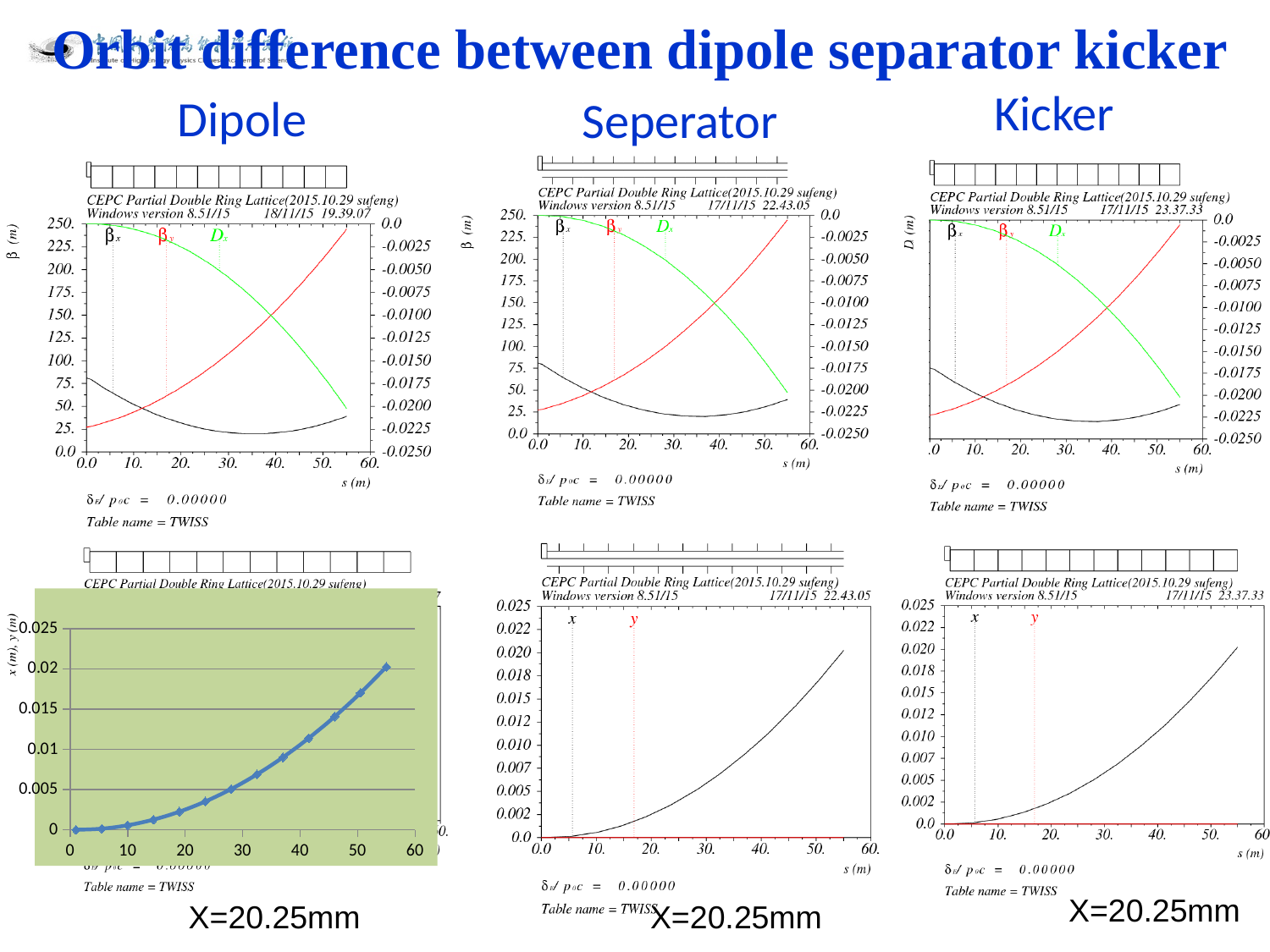
What X value is printed beneath each of the three bottom orbit charts? X=20.25mm In the bottom-left chart under the Dipole column, is the value at the last point (around s=55) greater or less than 0.015? greater In the bottom-middle orbit chart under the Seperator column, is the x value at s=55 greater or less than 0.015? greater In the bottom-right orbit chart under the Kicker column, is the x value at s=20 greater or less than 0.005? less How many series are labelled in the top-left Twiss chart under the Dipole column? 3 In the top-left Twiss chart under the Dipole column, which colour is used for the Dx curve? green What kind of chart is the bottom-left chart with the green background under the Dipole column? line chart In the top-right Twiss chart under the Kicker column, does the red βy curve rise or fall as s increases? rise In the bottom-left chart under the Dipole column, do the plotted values rise or fall as s increases from 0 to 60? rise In the top-middle Twiss chart under the Seperator column, does the green Dx curve rise or fall as s increases? fall